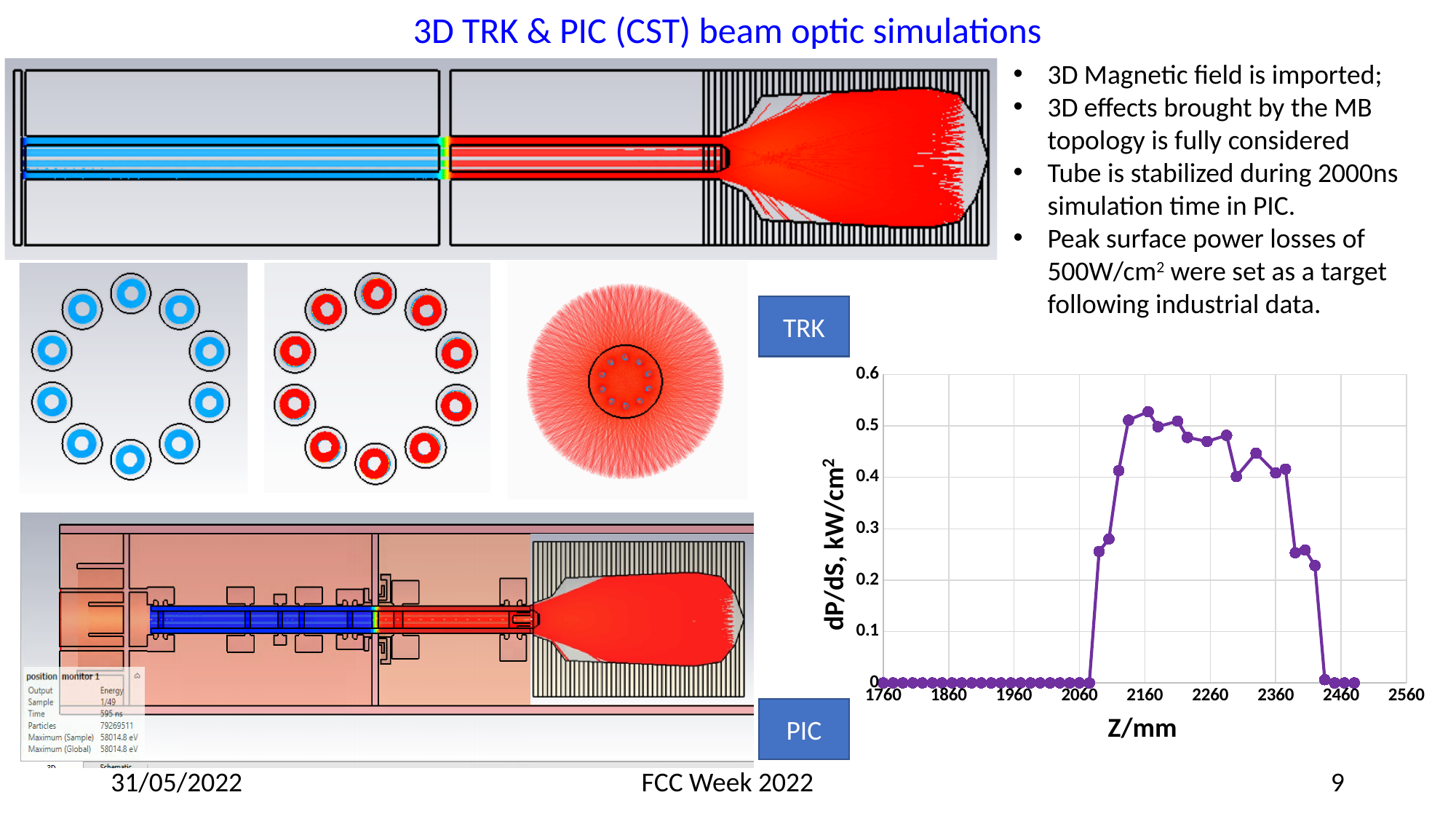
Is the value for Z = 2360 mm greater or less than 0.3? greater Is the value for Z = 1960 mm greater or less than 0.1? less What kind of chart is shown on the right side of the slide? line chart Is the value at Z = 2260 mm larger or smaller than the value at Z = 2360 mm? larger Do the values rise or fall along the x axis between Z = 2160 mm and Z = 2460 mm? fall What is the highest tick value shown on the y-axis of the chart? 0.6 Is the peak value of the curve greater or less than 0.5? greater What is the label of the y-axis of the chart? dP/dS, kW/cm² Do the values rise or fall along the x axis between Z = 2060 mm and Z = 2160 mm? rise What is the label of the x-axis of the chart? Z/mm